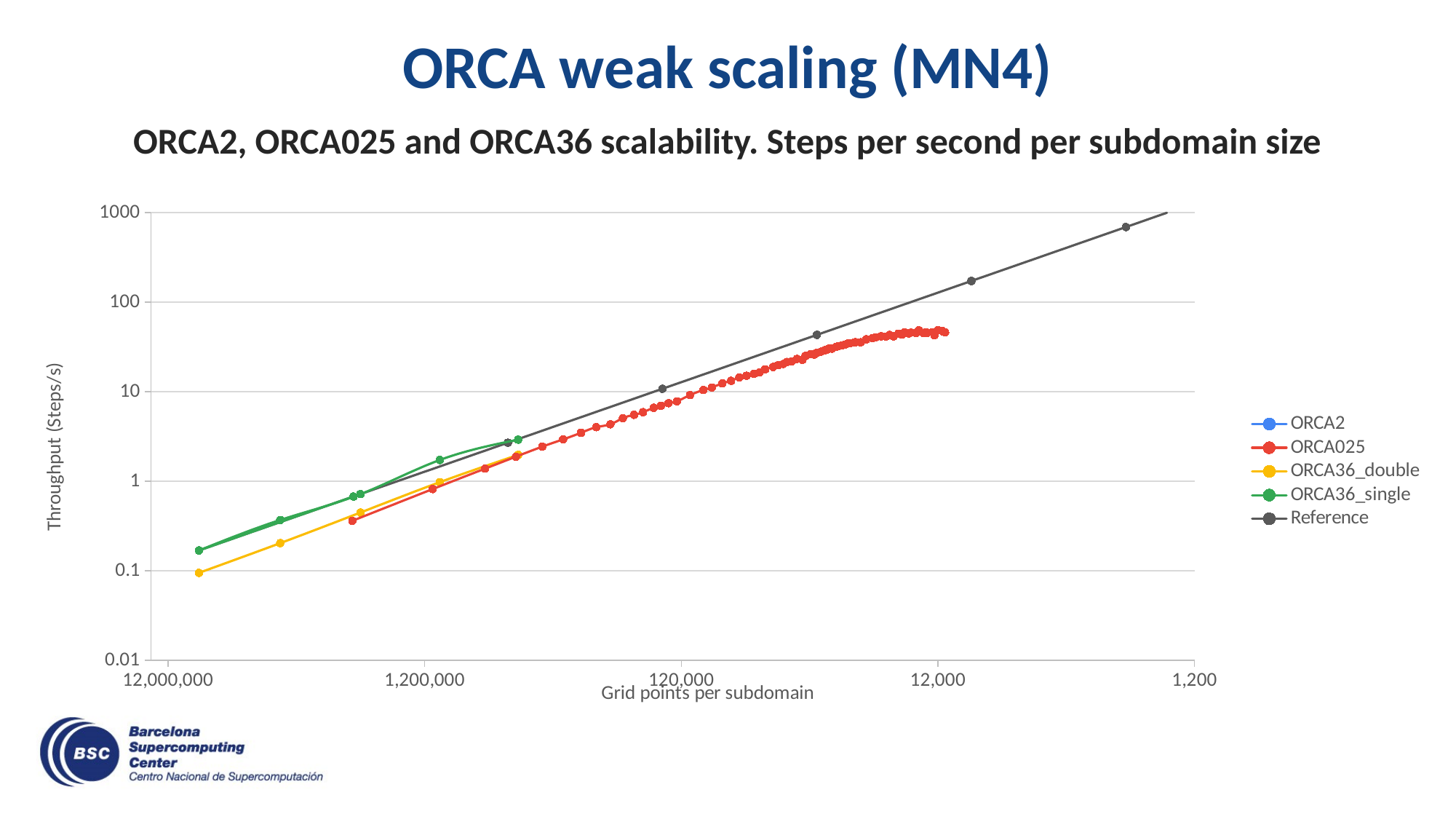
Is the highest throughput reached by ORCA025 greater or less than 100 Steps/s? less Moving from left to right along the x axis, does the throughput of the Reference series rise or fall? rise Is the leftmost ORCA36_single point greater or less than 0.1 Steps/s? greater At around 1,200,000 grid points per subdomain, which series has the higher throughput, ORCA36_single or ORCA36_double? ORCA36_single Which series reaches the highest throughput on the chart? Reference Is the Reference throughput at 12,000 grid points per subdomain greater or less than 100 Steps/s? greater Which series has the lowest plotted throughput value on the chart? ORCA36_double What is the label of the vertical axis? Throughput (Steps/s) What kind of chart is shown on the slide? line chart How many series does the legend list? 5 What is the title of the chart? ORCA2, ORCA025 and ORCA36 scalability. Steps per second per subdomain size